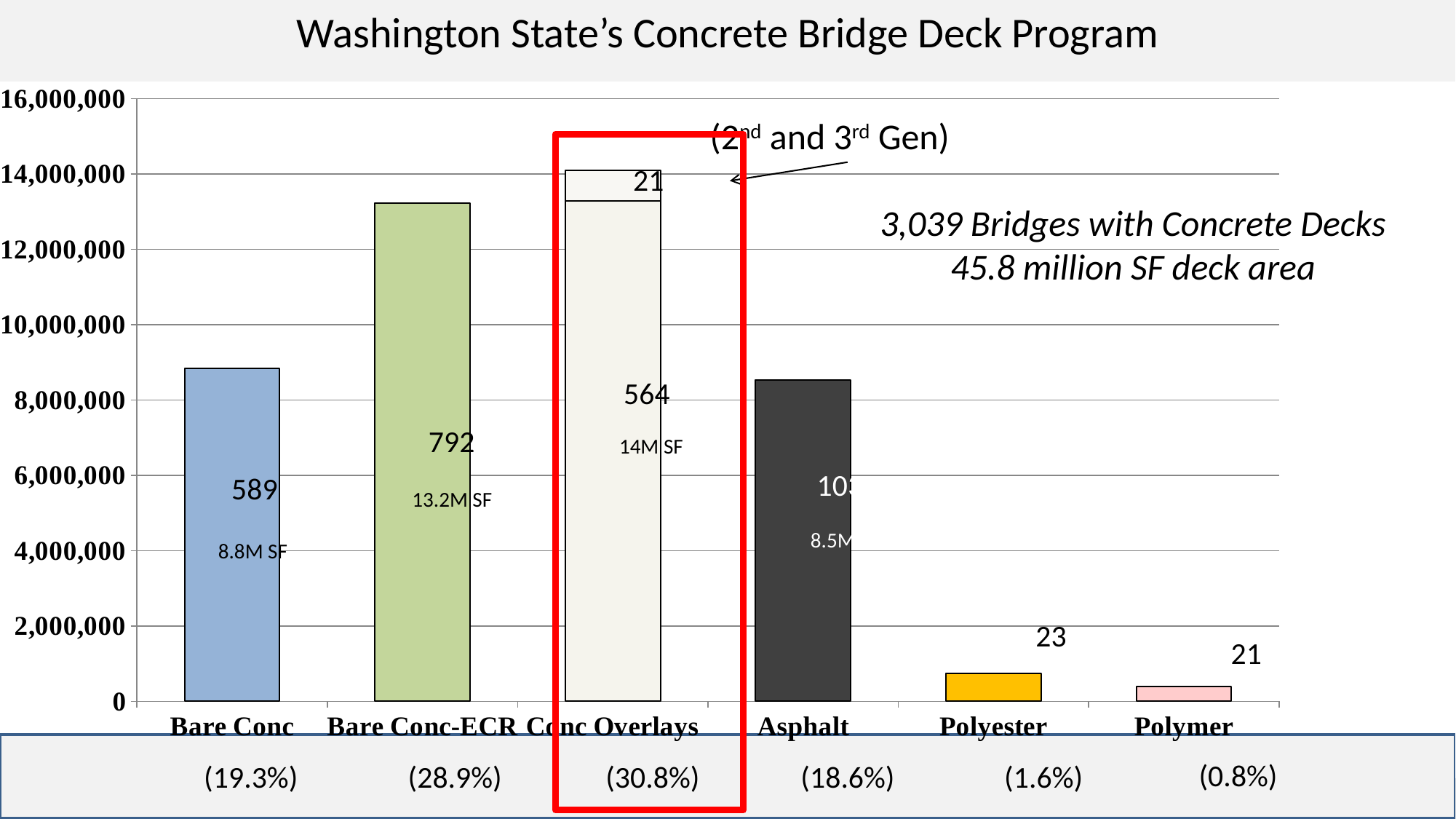
How many bridges are labelled on the Bare Conc bar? 589 Is the value for Bare Conc-ECR greater or less than 12,000,000? greater What deck area label is shown on the Conc Overlays bar? 14M SF Which deck type has the tallest bar? Conc Overlays How many bridges are labelled on the Bare Conc-ECR bar? 792 Which deck type has the shortest bar? Polymer How many deck type categories are shown on the x axis? 6 What kind of chart is shown on the slide? bar chart Is the value for Polyester greater or less than 2,000,000? less What is the title of the slide? Washington State's Concrete Bridge Deck Program What number is labelled above the Polyester bar? 23 What percentage is shown below the Bare Conc-ECR category? 28.9%